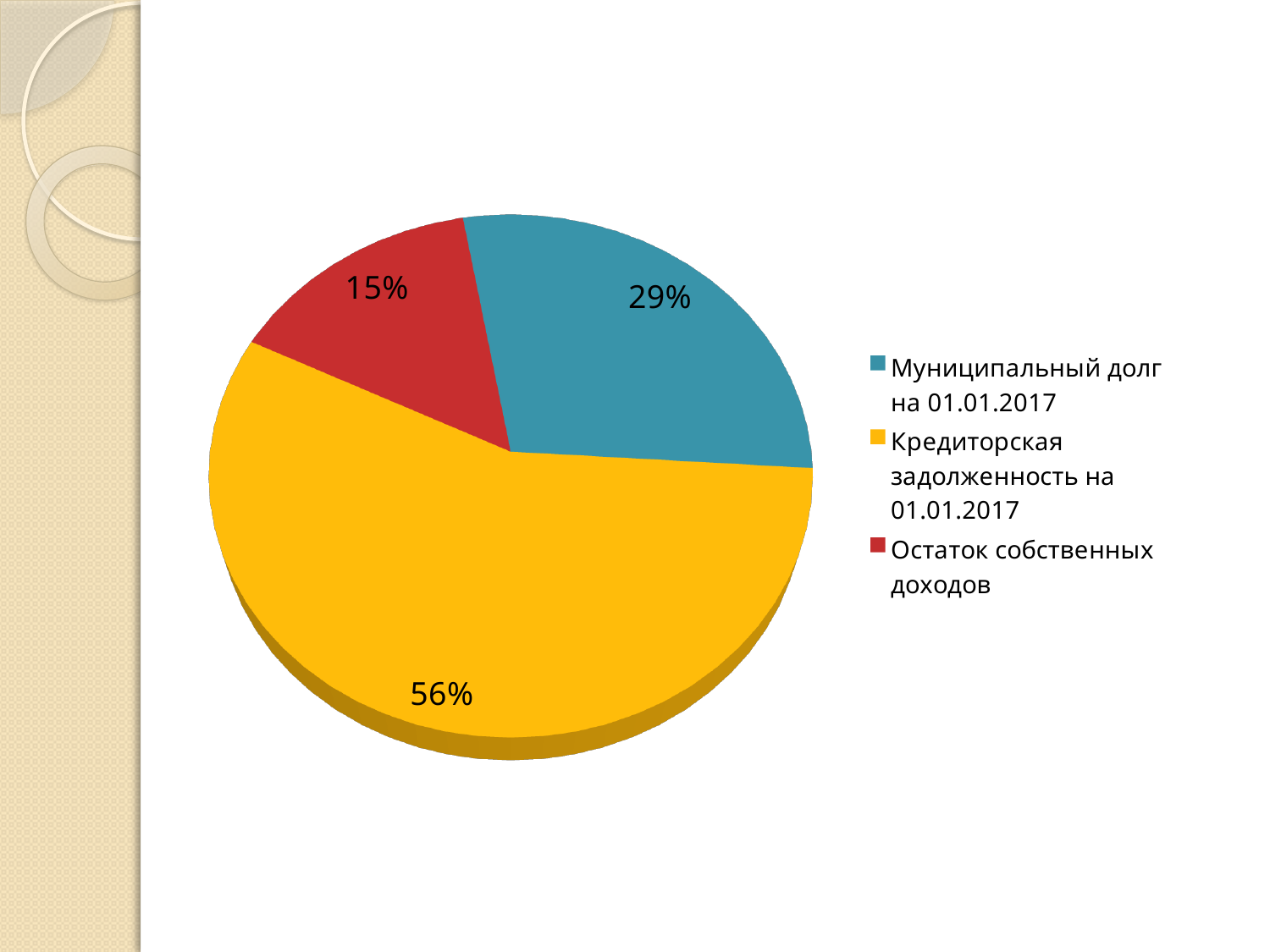
What share of the pie does "Муниципальный долг на 01.01.2017" have? 29% How many slices does the pie chart have? 3 How many entries does the legend list? 3 What share of the pie does "Кредиторская задолженность на 01.01.2017" have? 56% What is the difference in percentage points between "Кредиторская задолженность на 01.01.2017" and "Муниципальный долг на 01.01.2017"? 27 Which category has the largest slice of the pie? Кредиторская задолженность на 01.01.2017 Which category has the smallest slice of the pie? Остаток собственных доходов What colour is the slice for "Остаток собственных доходов"? red What is the difference in percentage points between "Муниципальный долг на 01.01.2017" and "Остаток собственных доходов"? 14 Which is larger: the slice for "Муниципальный долг на 01.01.2017" or the slice for "Остаток собственных доходов"? Муниципальный долг на 01.01.2017 What kind of chart is shown on the slide? pie chart What share of the pie does "Остаток собственных доходов" have? 15%